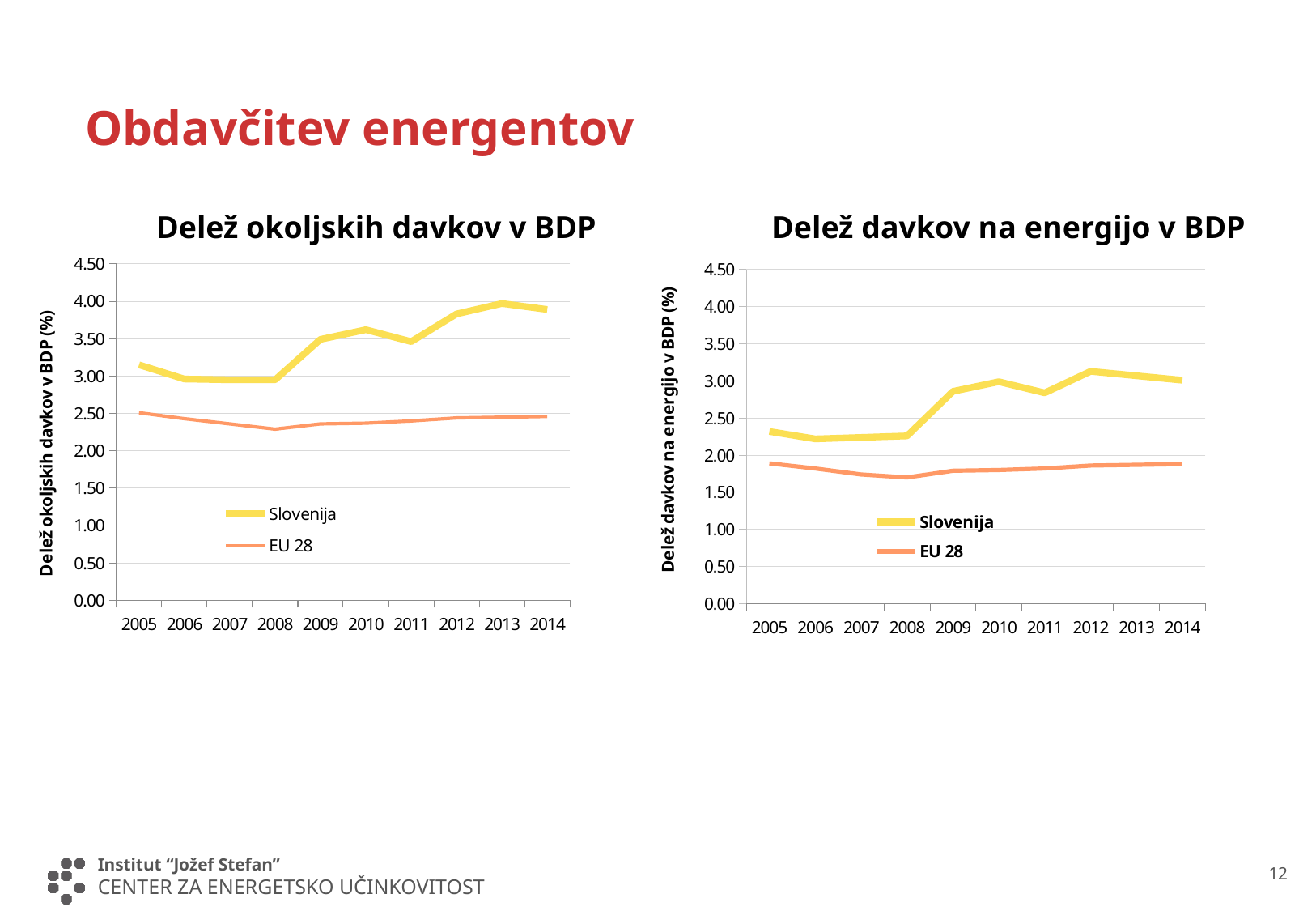
In the chart titled "Delež davkov na energijo v BDP", in which year is the EU 28 value lowest? 2008 In the chart titled "Delež davkov na energijo v BDP", is the value for EU 28 in 2008 greater or less than 2.00? less In the chart titled "Delež okoljskih davkov v BDP", is the value for Slovenija in 2013 greater or less than 3.50? greater In the chart titled "Delež okoljskih davkov v BDP", in which year is the EU 28 value lowest? 2008 In the chart titled "Delež okoljskih davkov v BDP", is the value for EU 28 in 2008 greater or less than 2.50? less In the chart titled "Delež davkov na energijo v BDP", which series has the higher value in 2014, Slovenija or EU 28? Slovenija What is the y-axis label of the chart titled "Delež davkov na energijo v BDP"? Delež davkov na energijo v BDP (%) In the chart titled "Delež okoljskih davkov v BDP", does the Slovenija series rise or fall between 2008 and 2009? rise What kind of chart is the chart titled "Delež okoljskih davkov v BDP"? line chart How many years are shown on the x axis of the chart titled "Delež okoljskih davkov v BDP"? 10 How many series does the legend list in the chart titled "Delež davkov na energijo v BDP"? 2